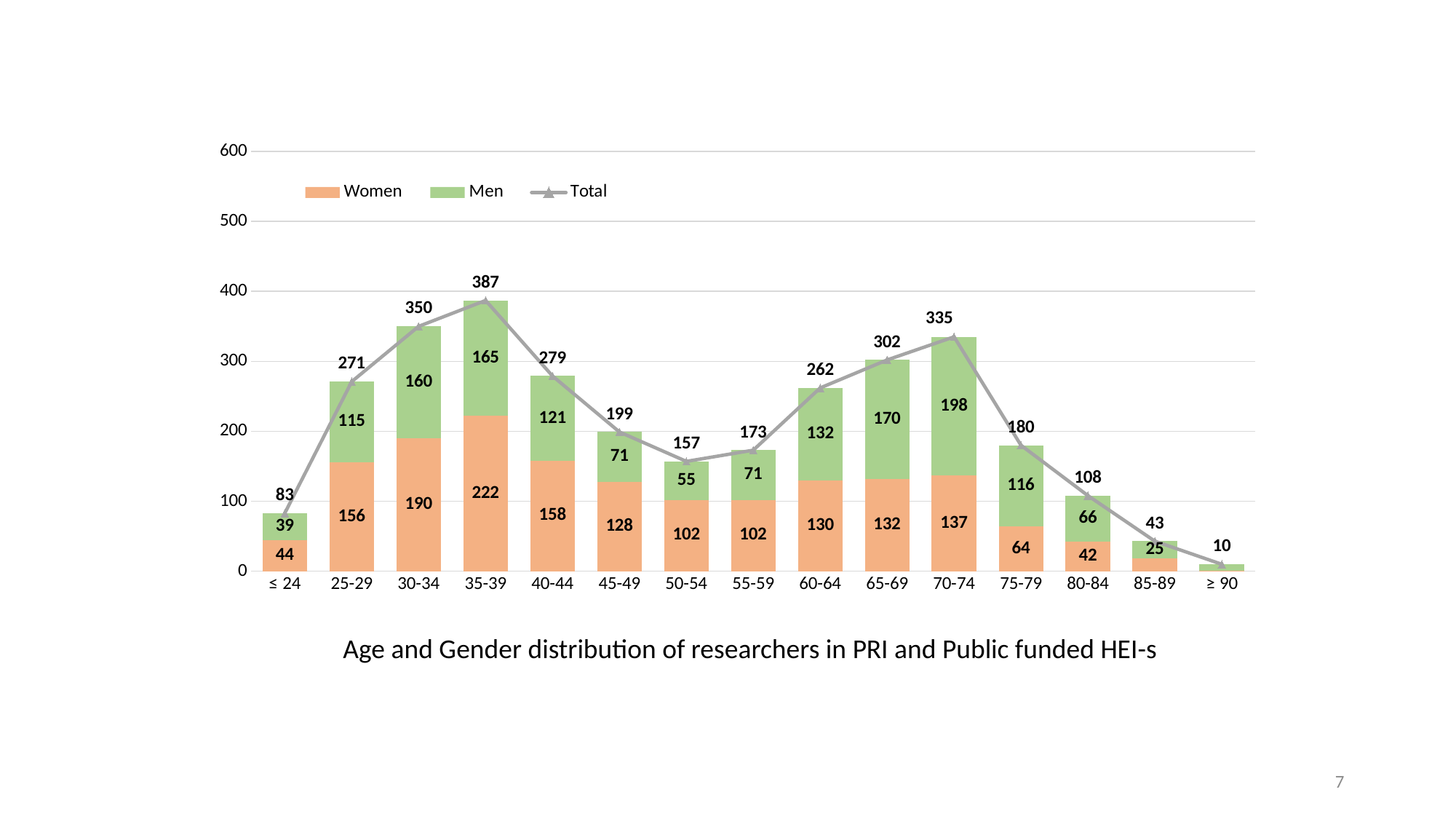
How many women researchers are in the 35-39 age group? 222 What kind of chart is used to show the Women and Men values? Stacked bar chart Which age group has the highest Total? 35-39 What is the number of men in the 70-74 age group? 198 What is the difference between the number of men and the number of women in the 65-69 age group? 38 What is the title shown below the chart? Age and Gender distribution of researchers in PRI and Public funded HEI-s Which is larger in the 45-49 age group: the number of women or the number of men? Women What is the Total value for the 60-64 age group? 262 How many age groups are shown on the x axis? 15 Is the Total for the 25-29 age group greater or less than 300? less How many series does the legend list? 3 Which age group has the lowest Total? ≥ 90